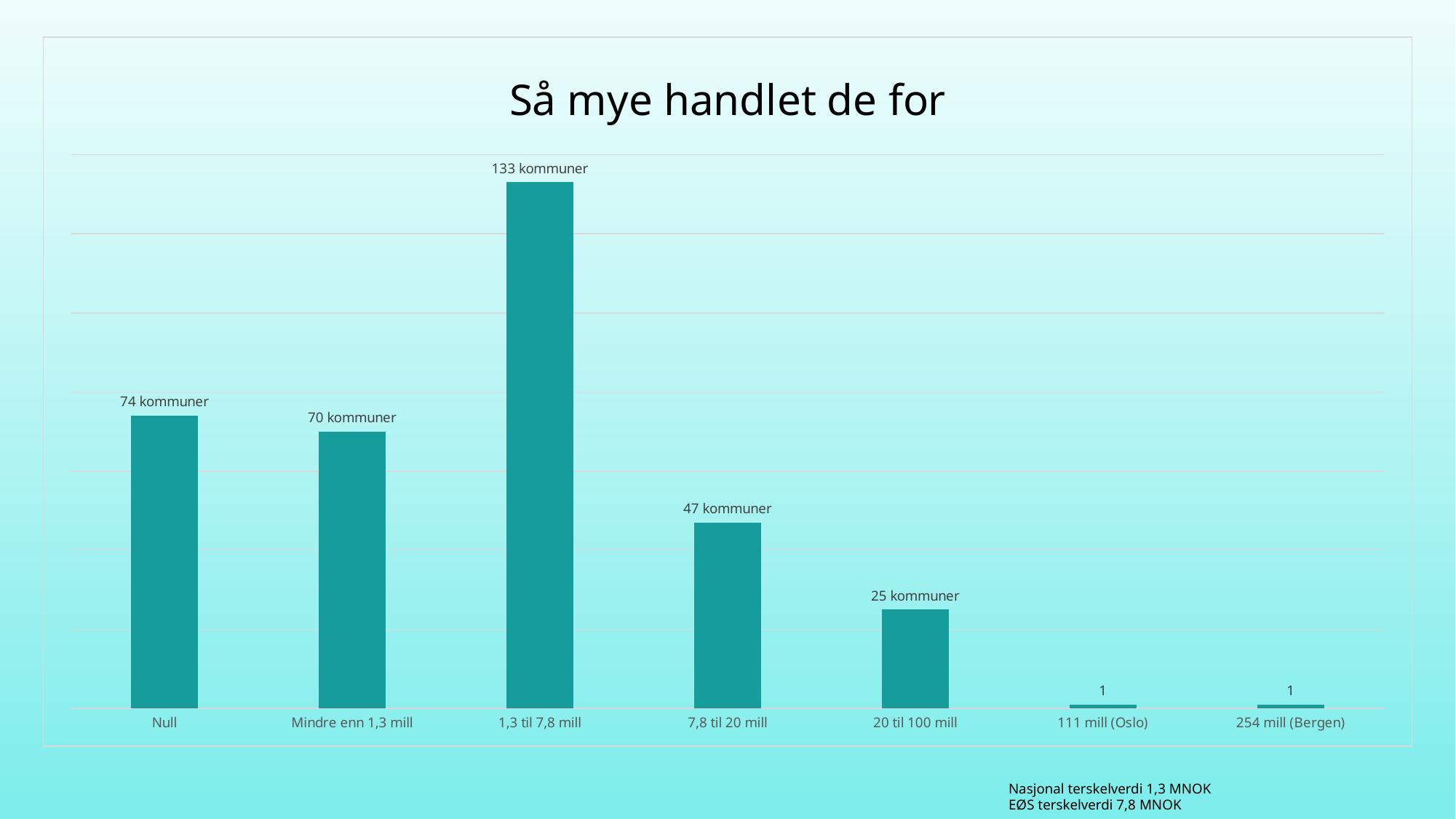
What kind of chart is shown on the slide? bar chart What is the value for the 'Null' category? 74 kommuner What is the title of the chart? Så mye handlet de for How many categories are shown on the x axis? 7 What is the value for the '20 til 100 mill' category? 25 kommuner What is the value for the '1,3 til 7,8 mill' category? 133 kommuner What is the total of the values for '111 mill (Oslo)' and '254 mill (Bergen)'? 2 Which category has the highest value? 1,3 til 7,8 mill What is the value for the '111 mill (Oslo)' category? 1 Which is larger, the value for '7,8 til 20 mill' or the value for '20 til 100 mill'? 7,8 til 20 mill What is the difference between the values for '1,3 til 7,8 mill' and '7,8 til 20 mill'? 86 What is the difference between the values for 'Null' and 'Mindre enn 1,3 mill'? 4